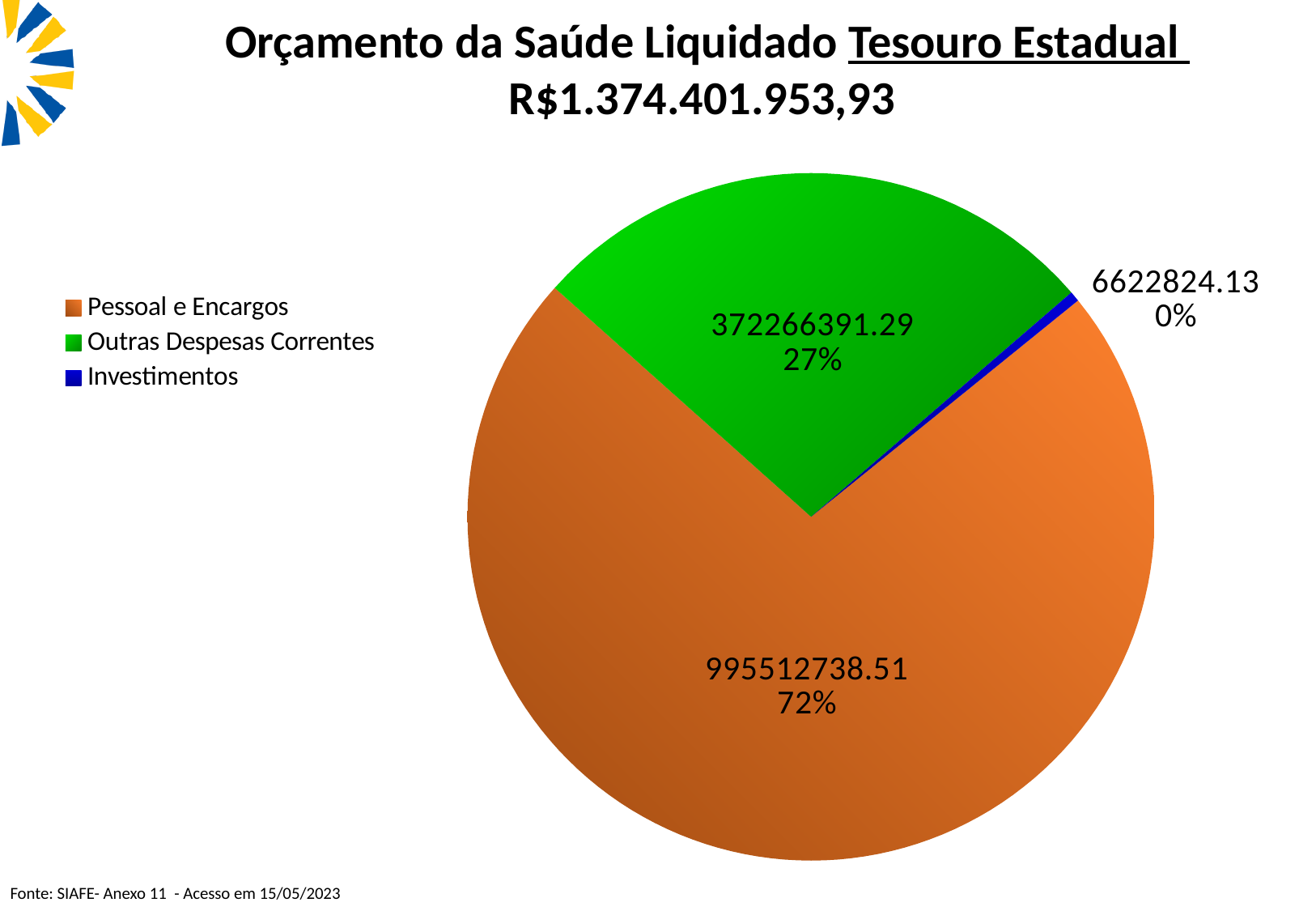
What is the difference between the values for Pessoal e Encargos and Outras Despesas Correntes? 623246347.22 What share of the pie does Investimentos represent? 0% What type of chart is shown on the slide? pie chart Which category has the smallest slice? Investimentos How many categories does the legend list? 3 What share of the pie does Outras Despesas Correntes represent? 27% Which category has the largest slice? Pessoal e Encargos Which is larger, Outras Despesas Correntes or Investimentos? Outras Despesas Correntes What share of the pie does Pessoal e Encargos represent? 72% What is the value for Investimentos? 6622824.13 What is the value for Pessoal e Encargos? 995512738.51 What is the value for Outras Despesas Correntes? 372266391.29